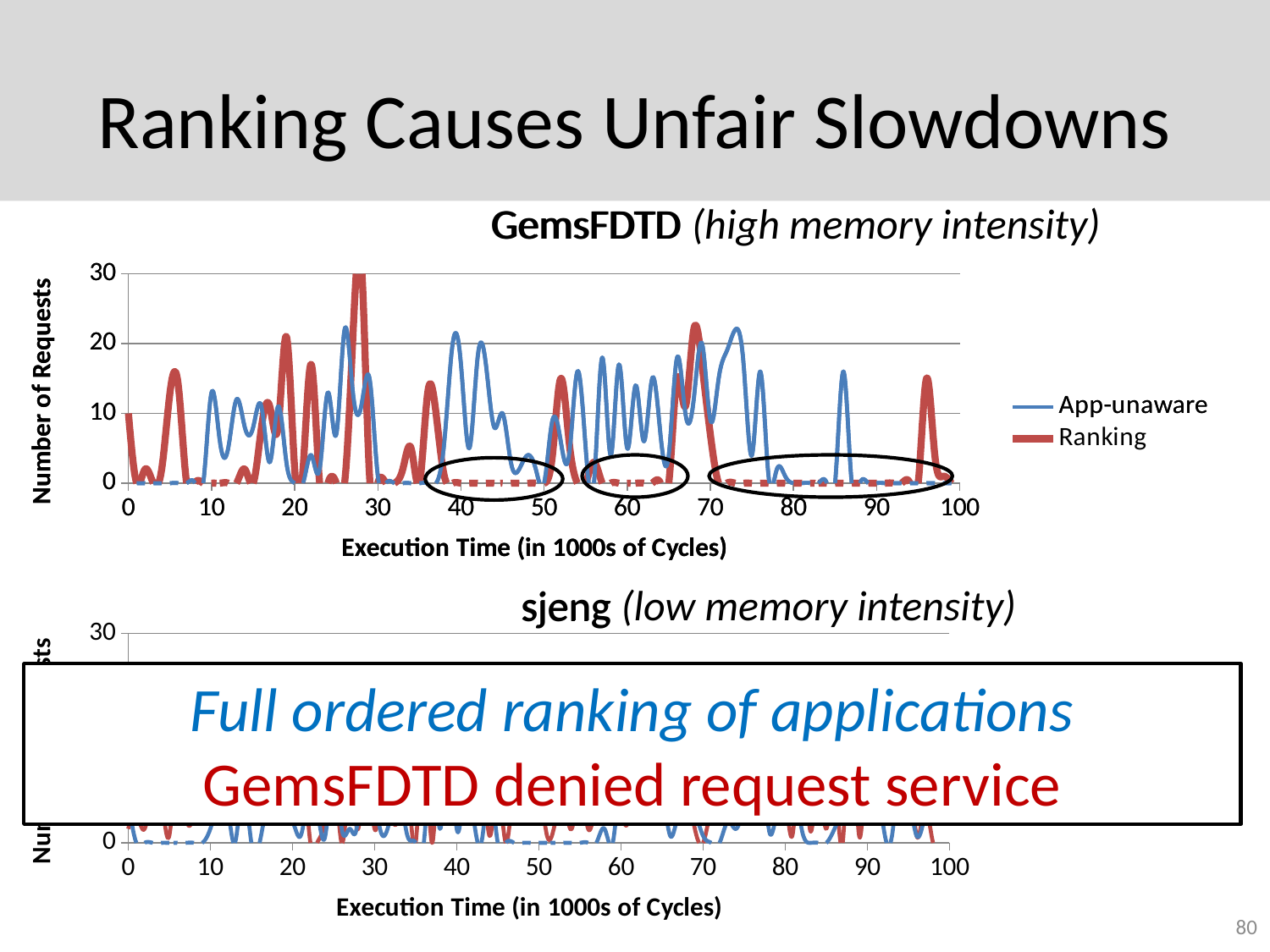
In the GemsFDTD (high memory intensity) chart, what are the two series named in the legend? App-unaware and Ranking In the GemsFDTD (high memory intensity) chart, how many series does the legend list? 2 In the GemsFDTD (high memory intensity) chart, is the value of the Ranking series at execution time 45 greater or less than 10? less In the GemsFDTD (high memory intensity) chart, what kind of chart is shown? line chart In the GemsFDTD (high memory intensity) chart, is the value of the App-unaware series at execution time 73 greater or less than 20? greater In the GemsFDTD (high memory intensity) chart, is the value of the Ranking series at execution time 60 greater or less than 10? less In the GemsFDTD (high memory intensity) chart, what is the highest value shown on the y axis? 30 In the GemsFDTD (high memory intensity) chart, what is the label of the x axis? Execution Time (in 1000s of Cycles) In the GemsFDTD (high memory intensity) chart, which series reaches the higher peak value overall, App-unaware or Ranking? Ranking